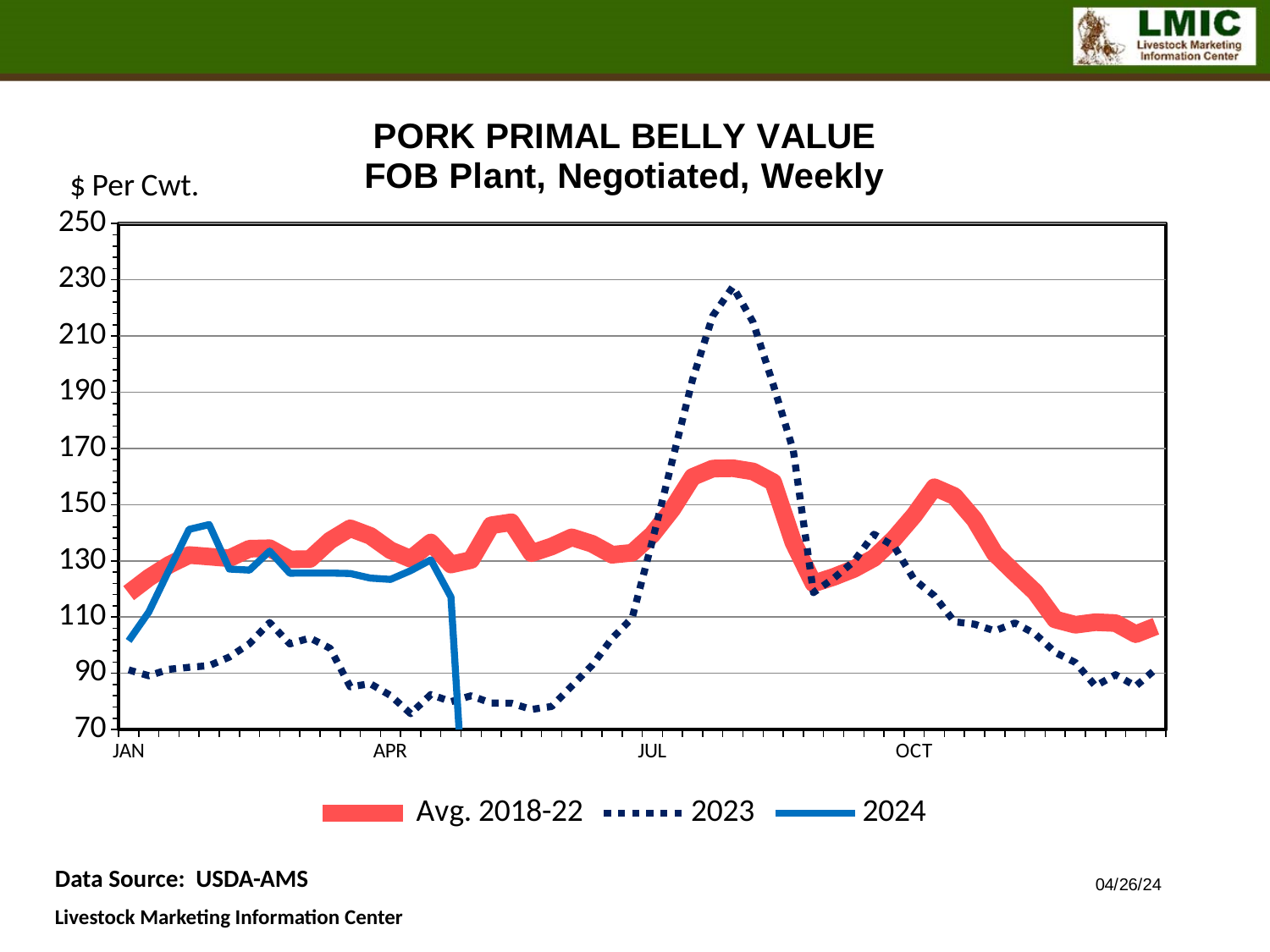
At JAN, which series has the higher value, Avg. 2018-22 or 2023? Avg. 2018-22 What kind of chart is shown on the slide? line chart How many series does the legend list? 3 Is the peak value of the 2023 series greater or less than 210? greater Is the value of the 2024 series at JAN greater or less than 90? greater Is the value of the 2023 series at APR greater or less than 90? less Does the Avg. 2018-22 series rise or fall from OCT to the end of the year? fall What are the three series listed in the legend? Avg. 2018-22, 2023, 2024 Which series reaches the highest value anywhere on the chart? 2023 What unit is shown on the y axis of the chart? $ Per Cwt.